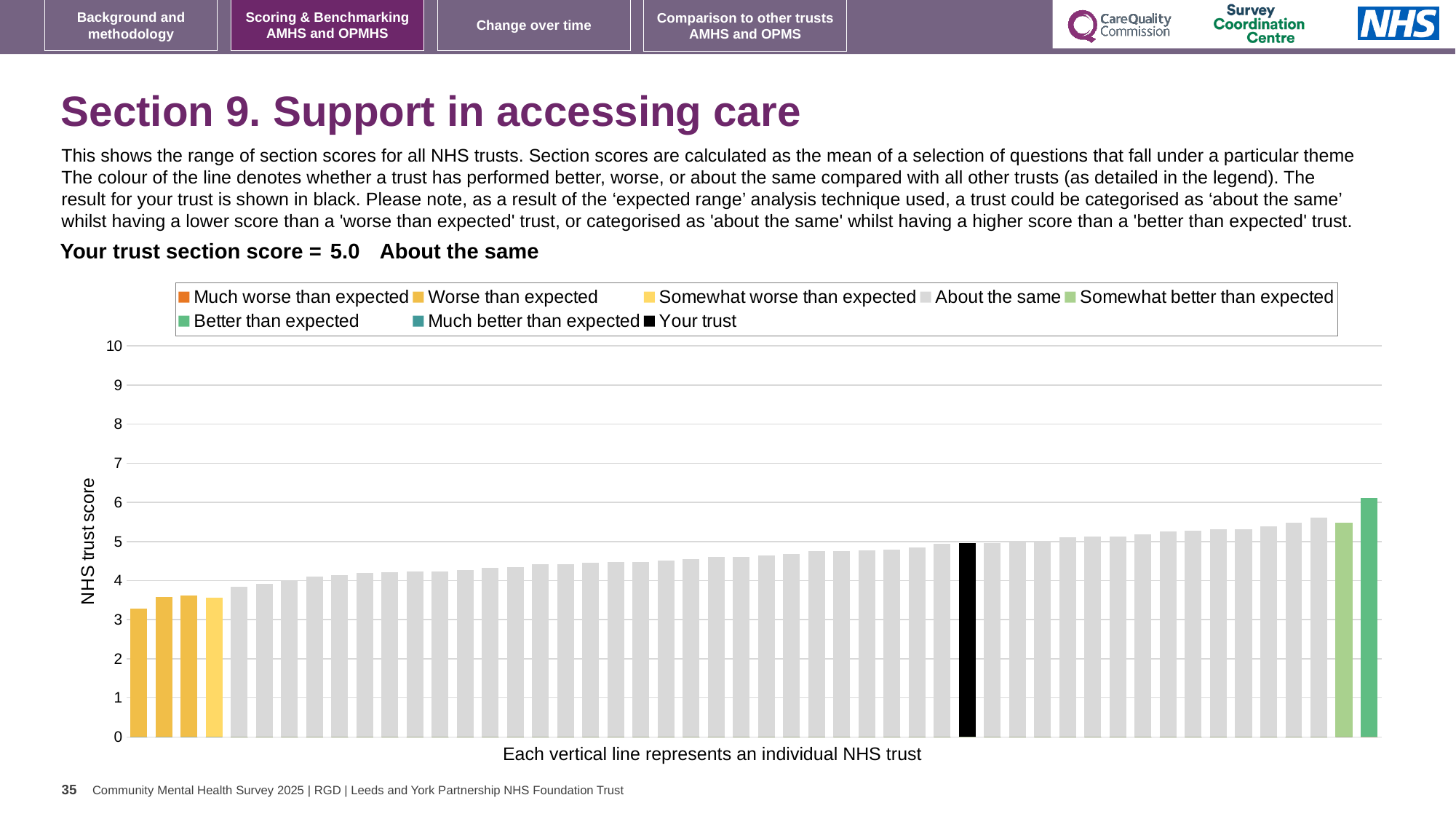
Which category is your trust placed in for this section? About the same Do the bar values rise or fall from left to right along the x axis? rise What is the label on the vertical axis of the chart? NHS trust score Is the value of the black bar (your trust) greater or less than 4? greater Which legend category does the tallest bar belong to? Better than expected Which is taller, the black bar or the rightmost bar? the rightmost bar What is the highest value shown on the vertical axis? 10 What kind of chart is shown on the slide? Bar chart Is the value of the tallest bar greater or less than 7? less Is the value of the leftmost bar greater or less than 4? less What is the section score for your trust shown on the slide? 5.0 How many entries does the chart legend list? 8